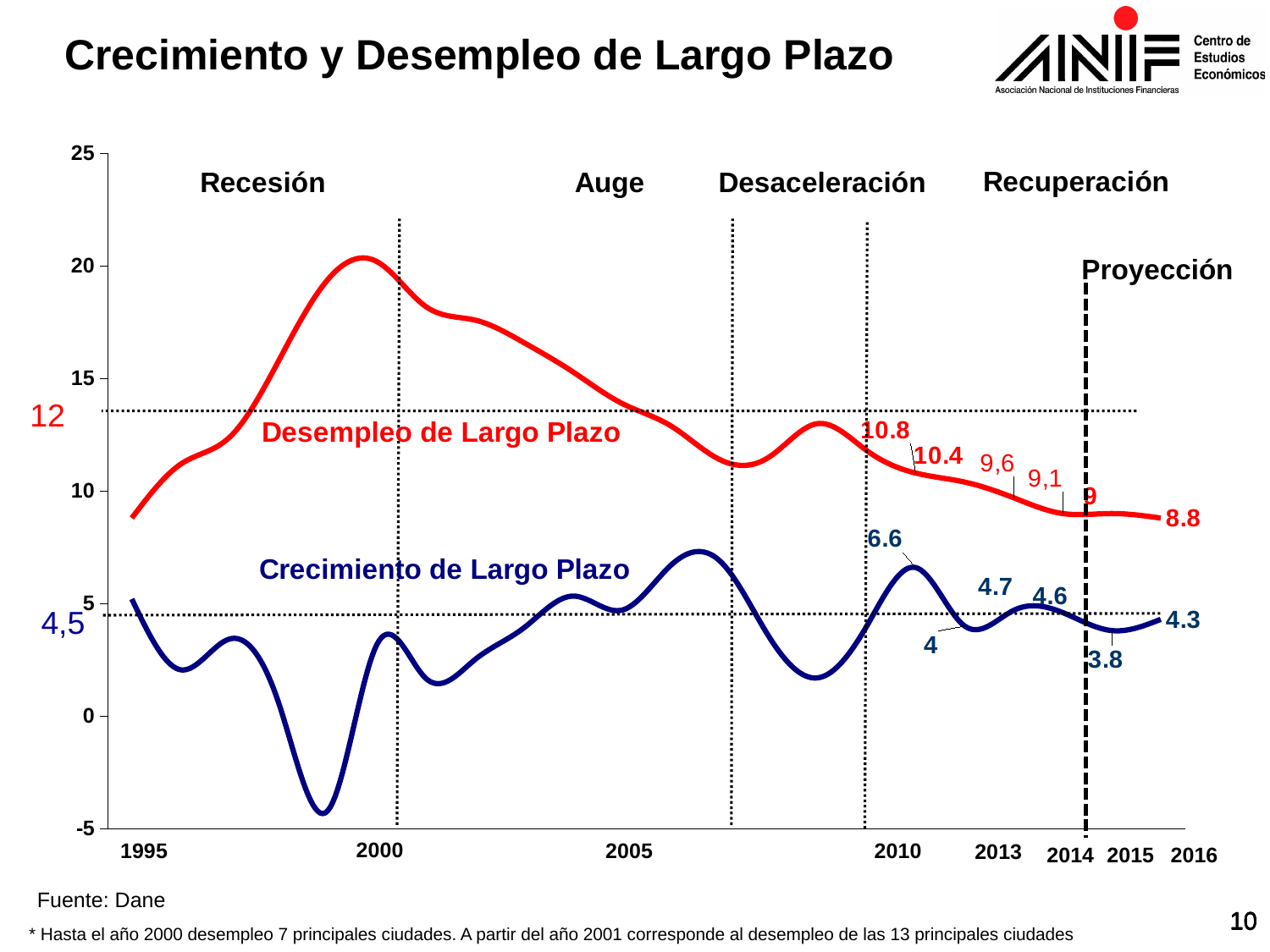
Does Desempleo de Largo Plazo rise or fall between 2010 and 2016? fall What are the four economic phases labelled across the top of the chart? Recesión, Auge, Desaceleración, Recuperación What is the value of Crecimiento de Largo Plazo at the end of the series in 2016? 4.3 What is the value of Desempleo de Largo Plazo at the end of the series in 2016? 8.8 Is the value of Desempleo de Largo Plazo in 2000 greater or less than 15? greater Which series reaches the highest value on the chart? Desempleo de Largo Plazo What is the difference between Desempleo de Largo Plazo (8.8) and Crecimiento de Largo Plazo (4.3) in 2016? 4.5 Is the lowest value reached by Crecimiento de Largo Plazo greater or less than 0? less What value is written in red at the left of the horizontal dotted reference line for Desempleo de Largo Plazo? 12 In 2016, which series has the higher value, Desempleo de Largo Plazo or Crecimiento de Largo Plazo? Desempleo de Largo Plazo What kind of chart is shown on the slide? line chart How many series are plotted on the chart? 2